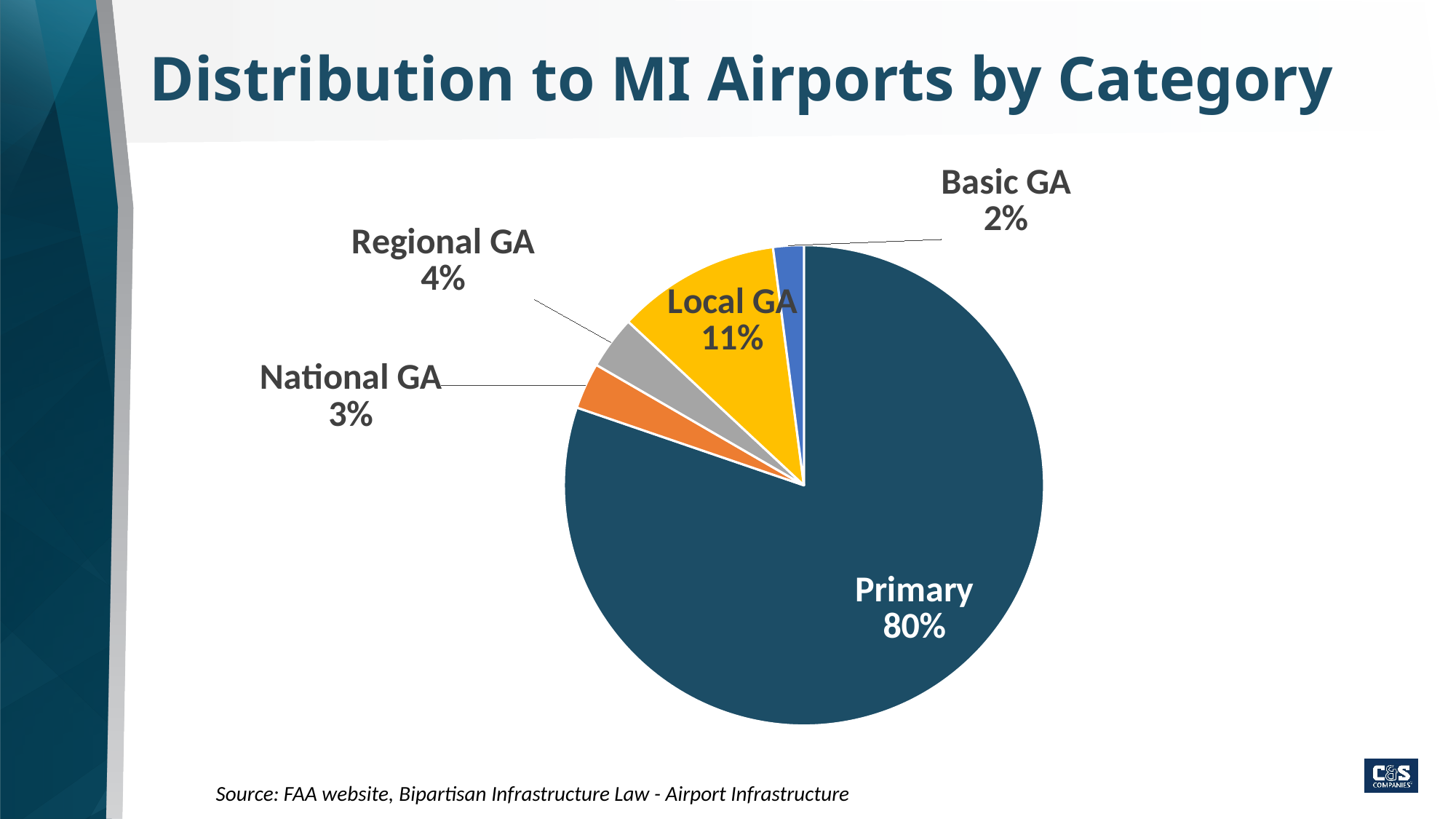
What share of the pie does Primary account for? 80% What is the value shown for National GA? 3% Which is larger, the share for Regional GA or the share for National GA? Regional GA How many categories are shown in the pie chart? 5 What is the value shown for Local GA? 11% Which category has the smallest slice of the pie? Basic GA What is the title of the chart on the slide? Distribution to MI Airports by Category Which category has the largest slice of the pie? Primary What is the value shown for Regional GA? 4% What is the difference between the Primary share and the Local GA share? 69% What is the value shown for Basic GA? 2% What kind of chart is shown on the slide? Pie chart